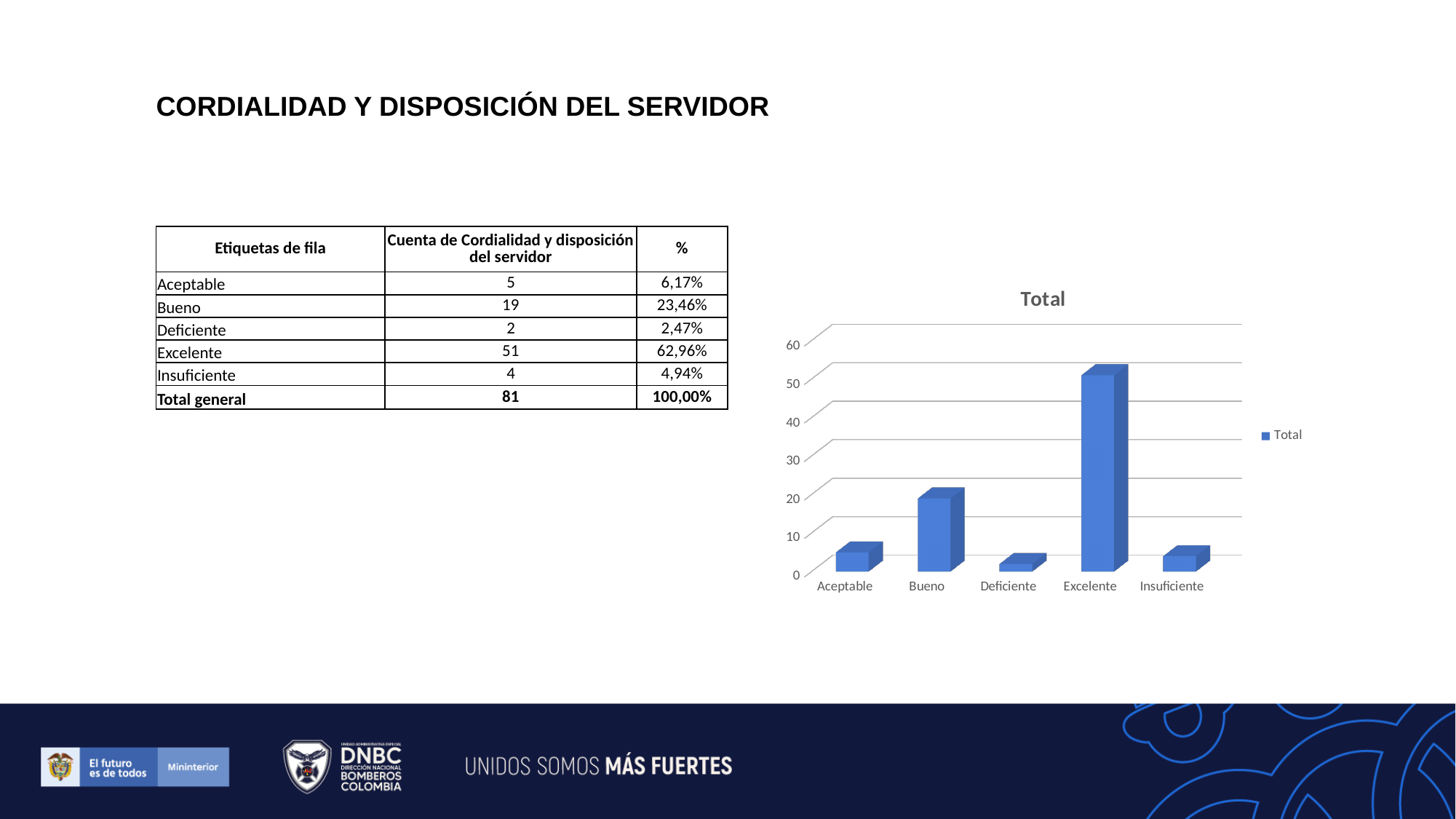
How many categories are shown on the x axis of the chart? 5 How many series does the chart legend list? 1 According to the table on the slide, what is the difference between the counts for Excelente and Bueno? 32 According to the table on the slide, what is the count for Excelente? 51 What type of chart is shown on the slide? bar chart Is the value for Excelente greater or less than 40? greater Is the value for Aceptable greater or less than 10? less What is the title of the chart? Total Which category has the highest bar in the chart? Excelente Which category has the lowest bar in the chart? Deficiente Which bar is taller, Bueno or Insuficiente? Bueno Is the value for Bueno greater or less than 20? less